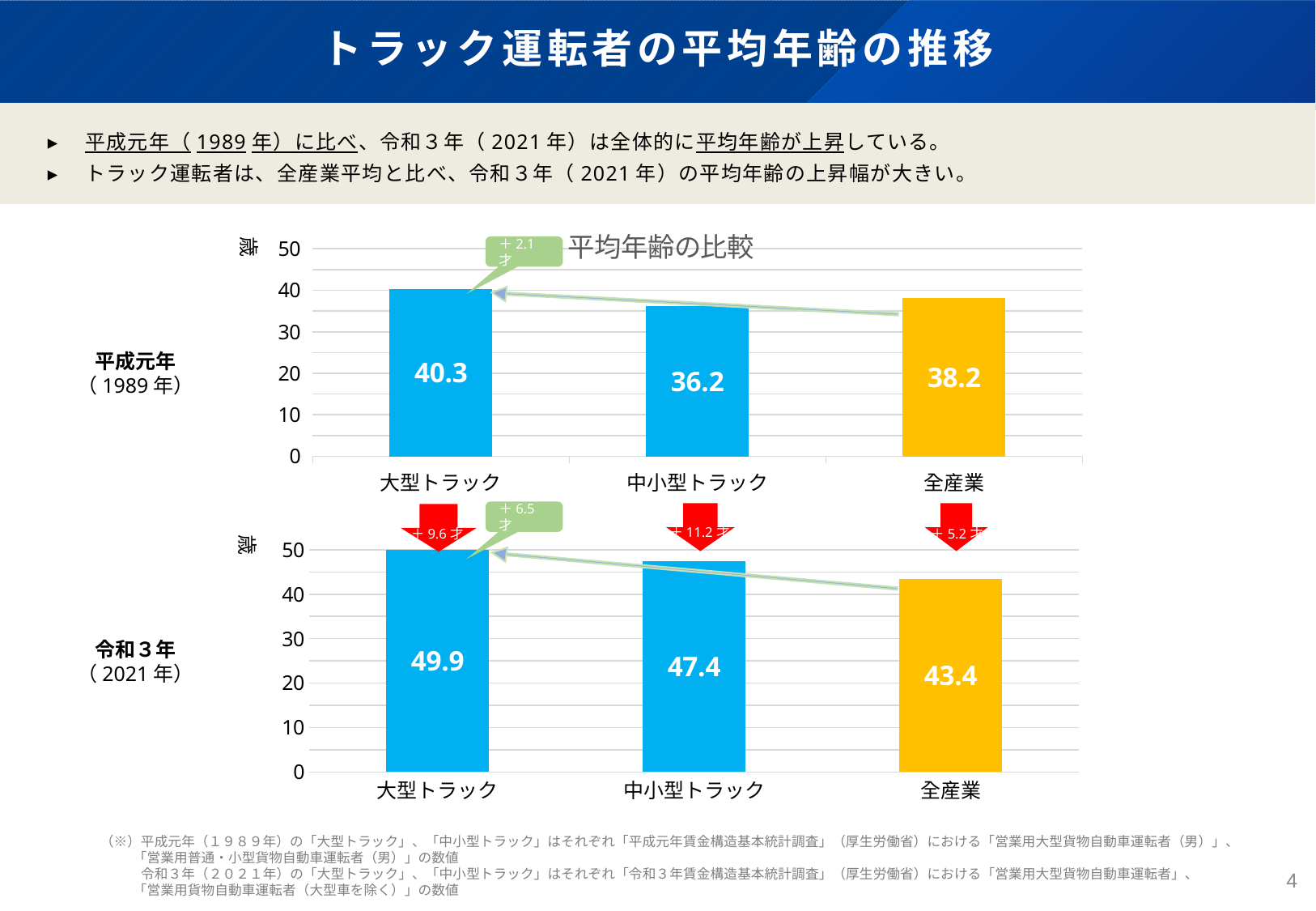
How many categories are shown in the top chart (平成元年 1989年)? 3 In the top chart (平成元年 1989年), what is the value for 全産業? 38.2 In the bottom chart (令和3年 2021年), is the value for 中小型トラック greater or less than 40? greater In the top chart (平成元年 1989年), which category has the lowest value? 中小型トラック In the bottom chart (令和3年 2021年), what is the difference between 中小型トラック and 全産業? 4.0 In the top chart (平成元年 1989年), which is larger, 大型トラック or 全産業? 大型トラック In the bottom chart (令和3年 2021年), what is the value for 全産業? 43.4 In the top chart (平成元年 1989年), what is the value for 大型トラック? 40.3 In the bottom chart (令和3年 2021年), which category has the highest value? 大型トラック What kind of chart is the bottom chart (令和3年 2021年)? bar chart In the top chart (平成元年 1989年), what is the value for 中小型トラック? 36.2 In the bottom chart (令和3年 2021年), what is the value for 大型トラック? 49.9